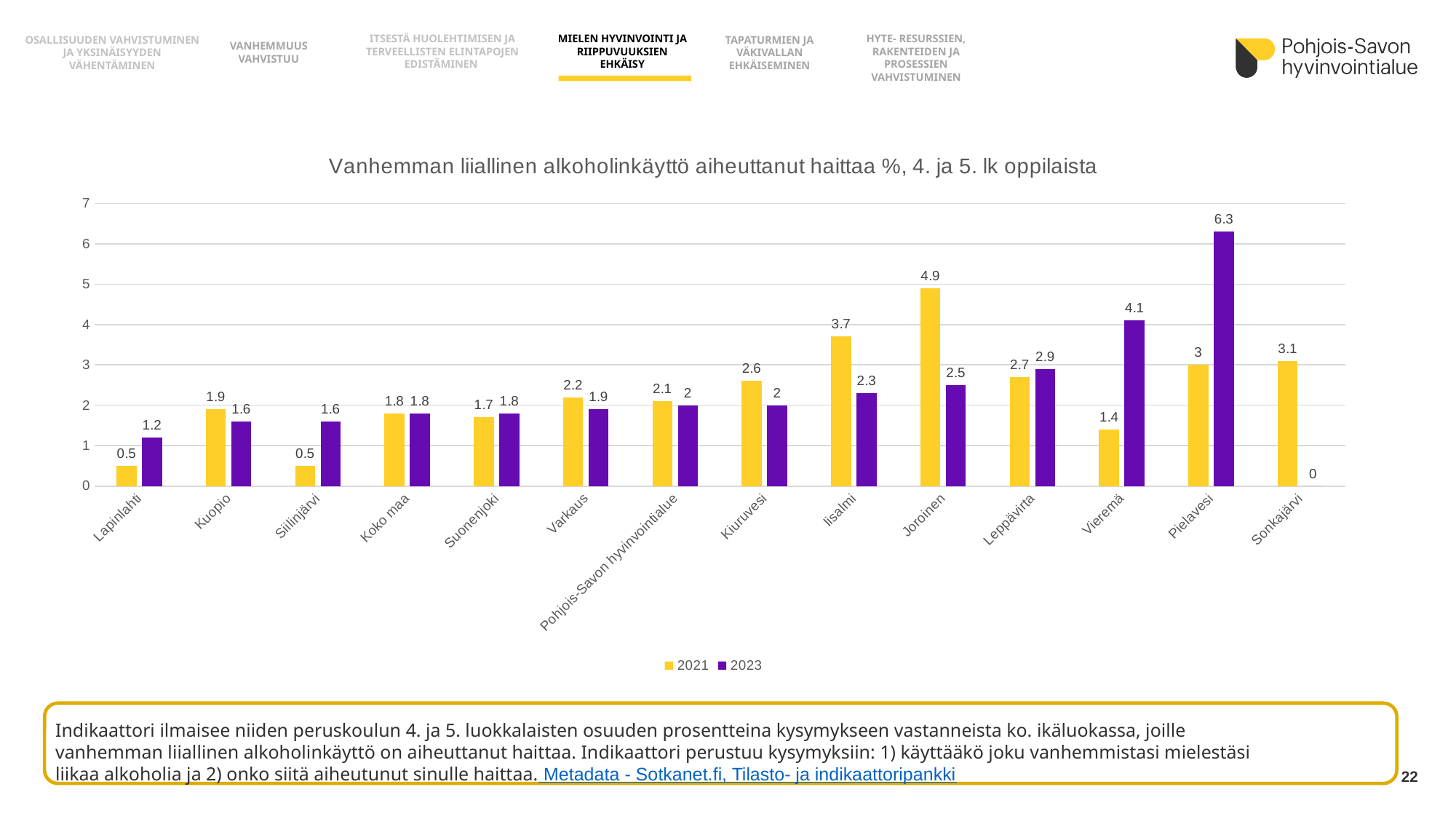
What is the 2023 value for Pielavesi? 6.3 What is the 2021 value for Joroinen? 4.9 Is the 2023 value for Pielavesi greater or less than 6? greater Which colour represents the 2023 series in the chart? Purple Which is larger for Iisalmi, the 2021 value or the 2023 value? 2021 What is the difference between the 2023 and 2021 values for Vieremä? 2.7 What kind of chart is shown on the slide? Bar chart Which category has the highest 2021 value? Joroinen How many categories are shown on the x axis? 14 Which category has the lowest 2023 value? Sonkajärvi How many series does the legend list? 2 What is the 2023 value for Sonkajärvi? 0